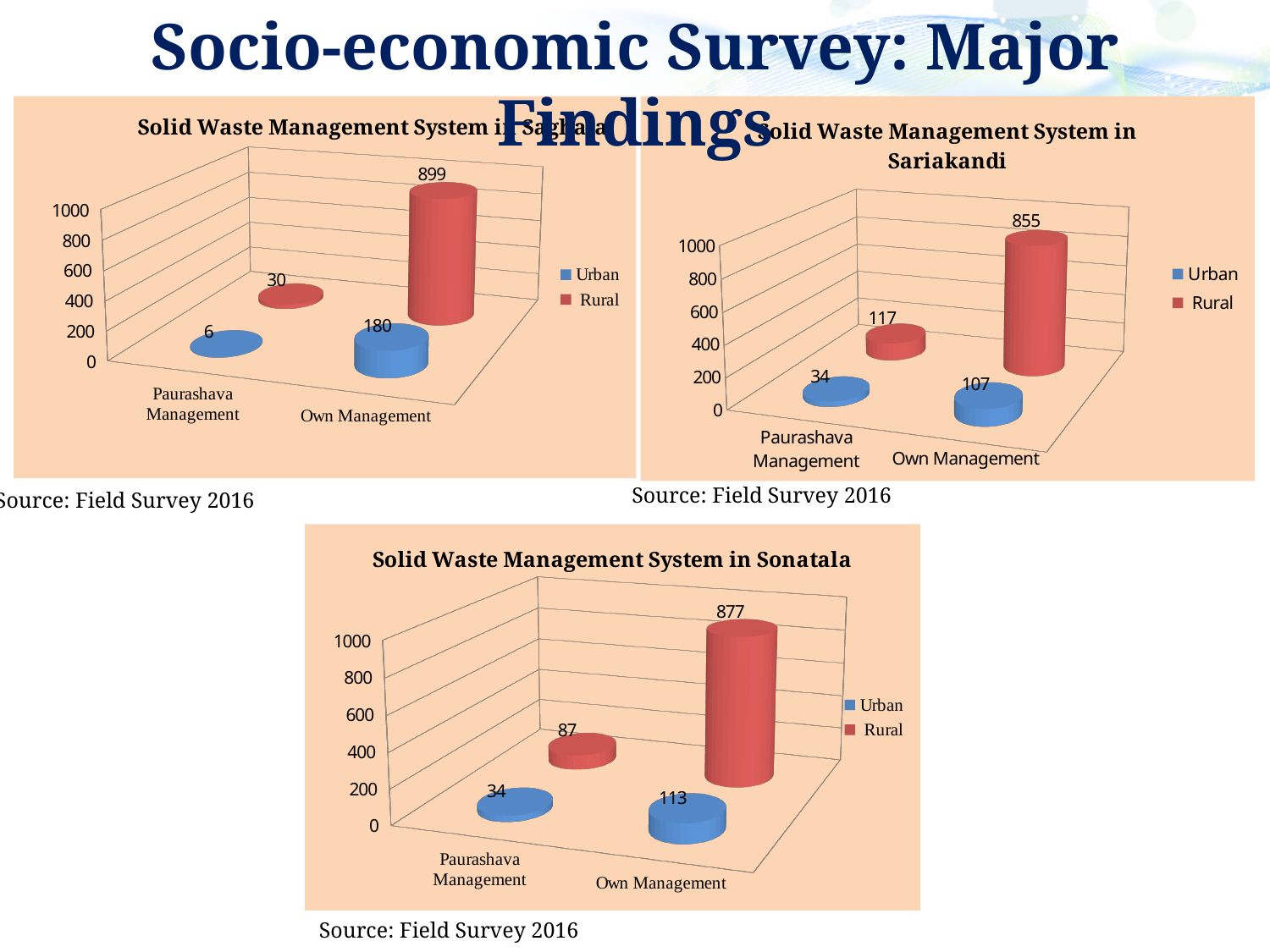
In the top-left chart, what is the Urban value for Paurashava Management? 6 How many categories are shown on the x axis of the Solid Waste Management System in Sariakandi chart? 2 In the Solid Waste Management System in Sonatala chart, what is the difference between the Rural values for Own Management and Paurashava Management? 790 In the Solid Waste Management System in Sariakandi chart, what is the difference between the Rural and Urban values for Own Management? 748 In the top-left chart, what is the difference between the Urban values for Own Management and Paurashava Management? 174 What kind of chart is the Solid Waste Management System in Sonatala chart? Bar chart In the top-left chart, what is the Rural value for Own Management? 899 In the Solid Waste Management System in Sonatala chart, what is the Urban value for Own Management? 113 In the Solid Waste Management System in Sariakandi chart, which is larger for Own Management, Urban or Rural? Rural In the Solid Waste Management System in Sariakandi chart, what is the Rural value for Paurashava Management? 117 In the Solid Waste Management System in Sonatala chart, which category has the highest Rural value? Own Management How many series does the legend list in the Solid Waste Management System in Sonatala chart? 2